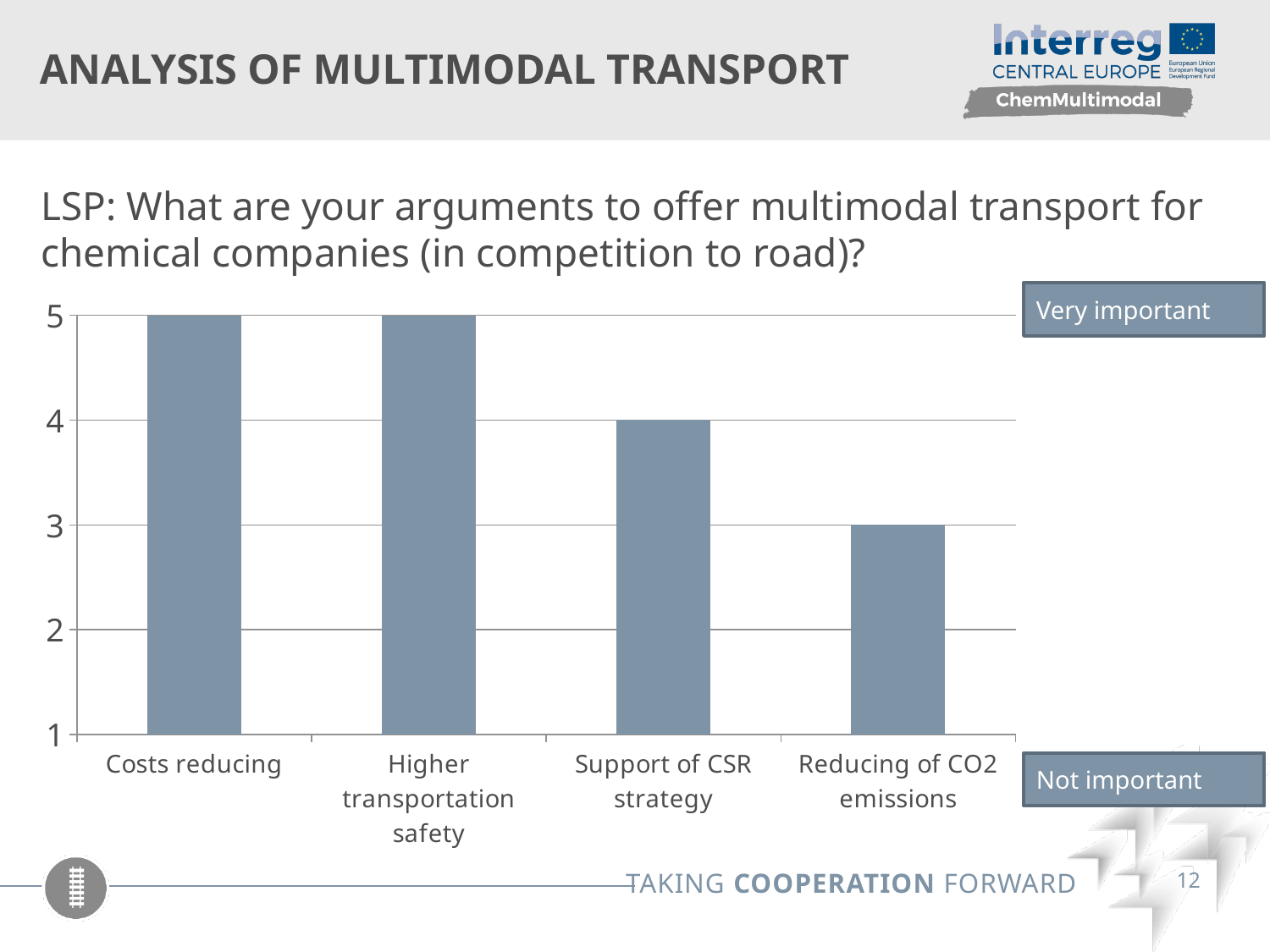
What value does the bar for Reducing of CO2 emissions reach? 3 Do the bar values rise or fall from left to right along the x axis? fall Is the value for Reducing of CO2 emissions greater or less than 4? less What value does the bar for Costs reducing reach? 5 What is the difference between the values for Support of CSR strategy and Reducing of CO2 emissions? 1 How many arguments (categories) are shown on the x axis? 4 What value does the bar for Higher transportation safety reach? 5 What is the difference between the values for Costs reducing and Reducing of CO2 emissions? 2 What kind of chart is shown on the slide? bar chart Which has a larger value, Support of CSR strategy or Reducing of CO2 emissions? Support of CSR strategy What value does the bar for Support of CSR strategy reach? 4 Which argument has the lowest bar? Reducing of CO2 emissions